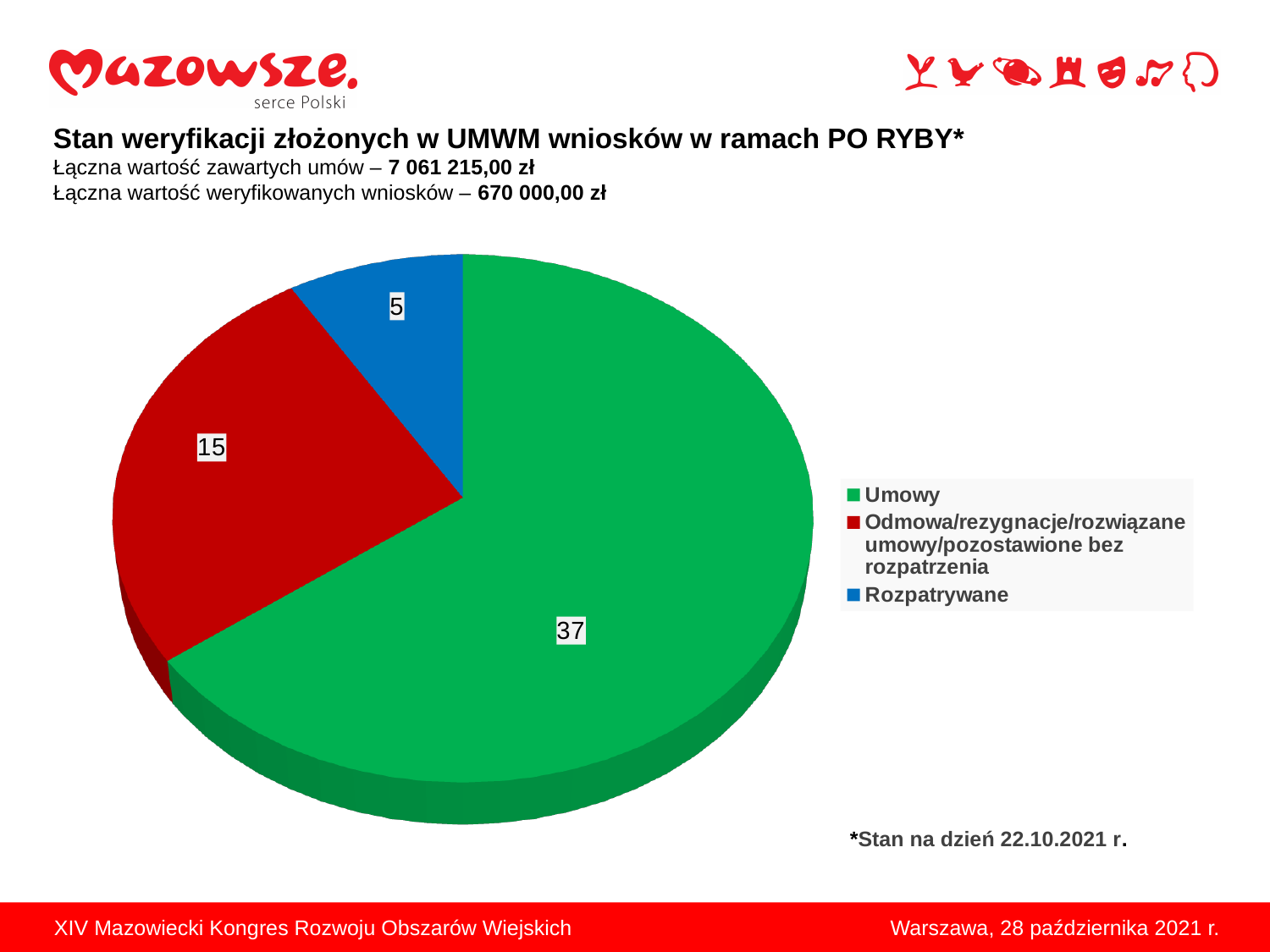
Which category has the smallest slice of the pie? Rozpatrywane Which category has the largest slice of the pie? Umowy What is the value for the "Odmowa/rezygnacje/rozwiązane umowy/pozostawione bez rozpatrzenia" slice? 15 What is the difference between the "Umowy" value and the "Rozpatrywane" value? 32 What colour is the "Rozpatrywane" slice? blue Which is larger: the "Odmowa/rezygnacje/rozwiązane umowy/pozostawione bez rozpatrzenia" slice or the "Rozpatrywane" slice? Odmowa/rezygnacje/rozwiązane umowy/pozostawione bez rozpatrzenia How many slices does the pie chart have? 3 What is the total of all the slice values in the pie chart? 57 What is the value for the "Rozpatrywane" slice? 5 What is the difference between the "Umowy" value and the "Odmowa/rezygnacje/rozwiązane umowy/pozostawione bez rozpatrzenia" value? 22 What type of chart is shown on the slide? pie chart What is the value for the "Umowy" slice? 37